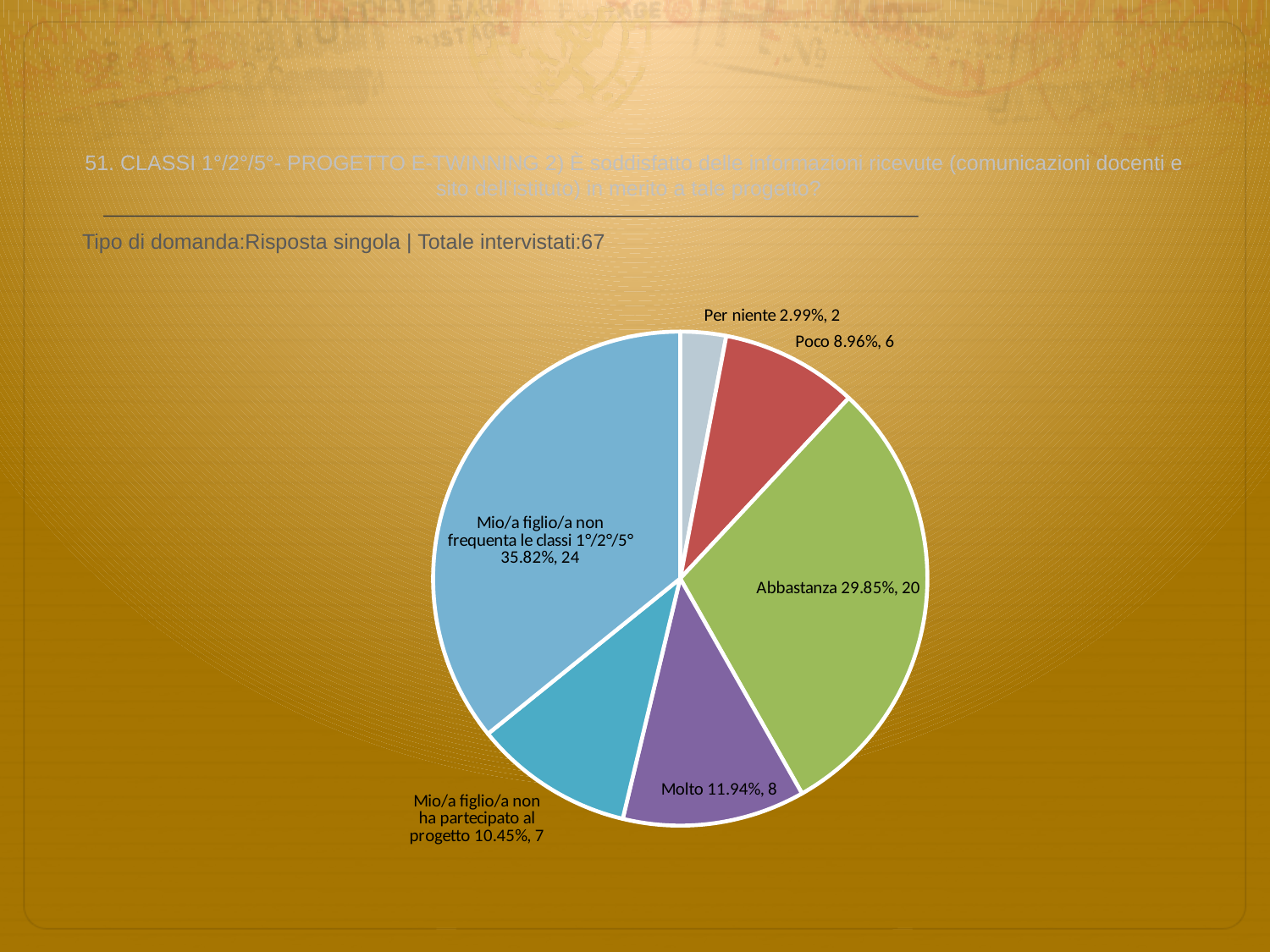
What is the count for the 'Per niente' slice? 2 How many slices does the pie chart have? 6 What is the percentage share of the 'Mio/a figlio/a non frequenta le classi 1°/2°/5°' slice? 35.82% Which is larger, the 'Poco' slice or the 'Mio/a figlio/a non ha partecipato al progetto' slice? Mio/a figlio/a non ha partecipato al progetto Which category has the smallest slice of the pie? Per niente What percentage share does the 'Molto' slice have? 11.94% What percentage share does the 'Poco' slice have? 8.96% What is the total number of respondents stated on the slide? 67 Which category has the largest slice of the pie? Mio/a figlio/a non frequenta le classi 1°/2°/5° What kind of chart is shown on the slide? pie chart What is the difference in count between 'Abbastanza' and 'Molto'? 12 What is the count for the 'Abbastanza' slice? 20